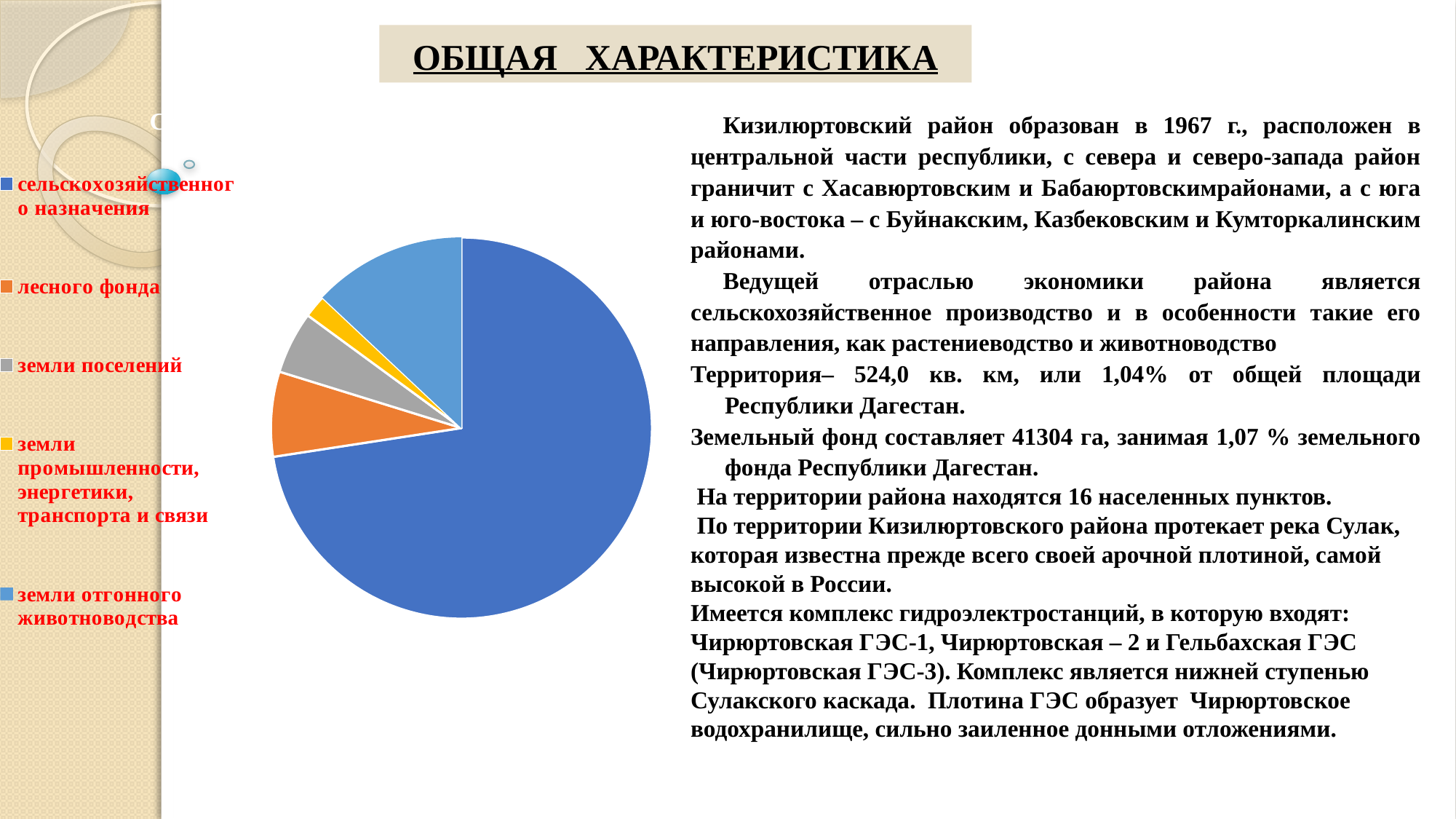
What kind of chart is shown on the slide? pie chart Which slice is larger: 'земли поселений' or 'земли промышленности, энергетики, транспорта и связи'? земли поселений How many categories does the pie chart have? 5 How many entries does the legend of the pie chart list? 5 Which category has the smallest slice of the pie chart? земли промышленности, энергетики, транспорта и связи What colour is the slice for 'земли промышленности, энергетики, транспорта и связи'? yellow Which slice is larger: 'лесного фонда' or 'земли отгонного животноводства'? земли отгонного животноводства Does the largest slice of the pie chart take up more or less than half of the pie? more Which slice is larger: 'сельскохозяйственного назначения' or 'лесного фонда'? сельскохозяйственного назначения What colour is the slice for 'лесного фонда' in the pie chart? orange Which category has the largest slice of the pie chart? сельскохозяйственного назначения